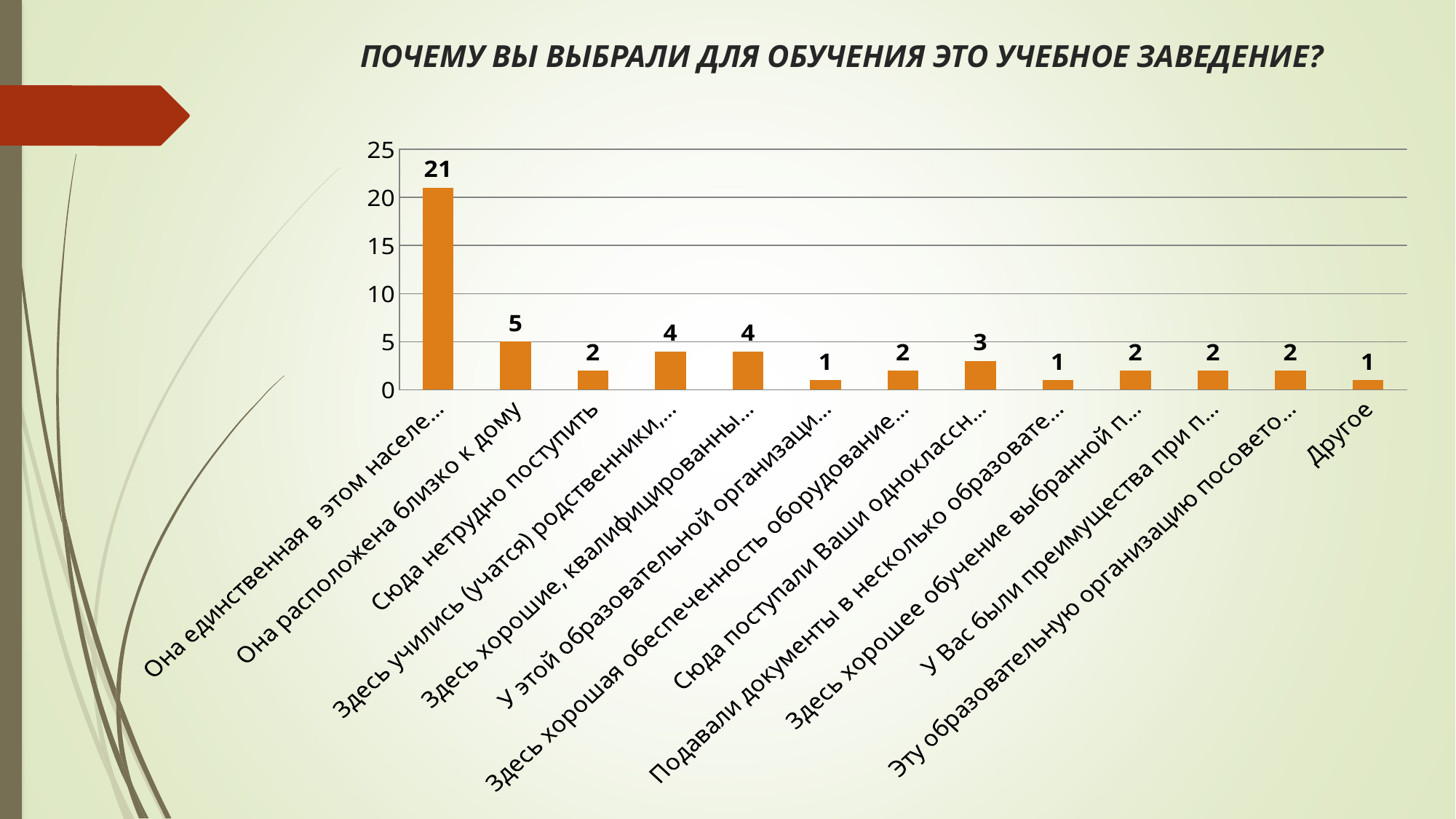
How many bars in the chart have a value of 2? 5 What value is shown for "Она расположена близко к дому"? 5 What is the difference between the value for "Она расположена близко к дому" and the value for "Сюда нетрудно поступить"? 3 What kind of chart is shown on the slide? Bar chart What is the difference between the tallest bar's value and the value for "Она расположена близко к дому"? 16 What value is shown for "Другое"? 1 What value is shown for "Сюда нетрудно поступить"? 2 Is the value of the first (leftmost) bar greater or less than 20? greater What is the value of the tallest bar in the chart? 21 Which has the larger value: "Другое" or "Сюда нетрудно поступить"? Сюда нетрудно поступить How many categories (bars) are shown in the chart? 13 What is the title of the slide? ПОЧЕМУ ВЫ ВЫБРАЛИ ДЛЯ ОБУЧЕНИЯ ЭТО УЧЕБНОЕ ЗАВЕДЕНИЕ?